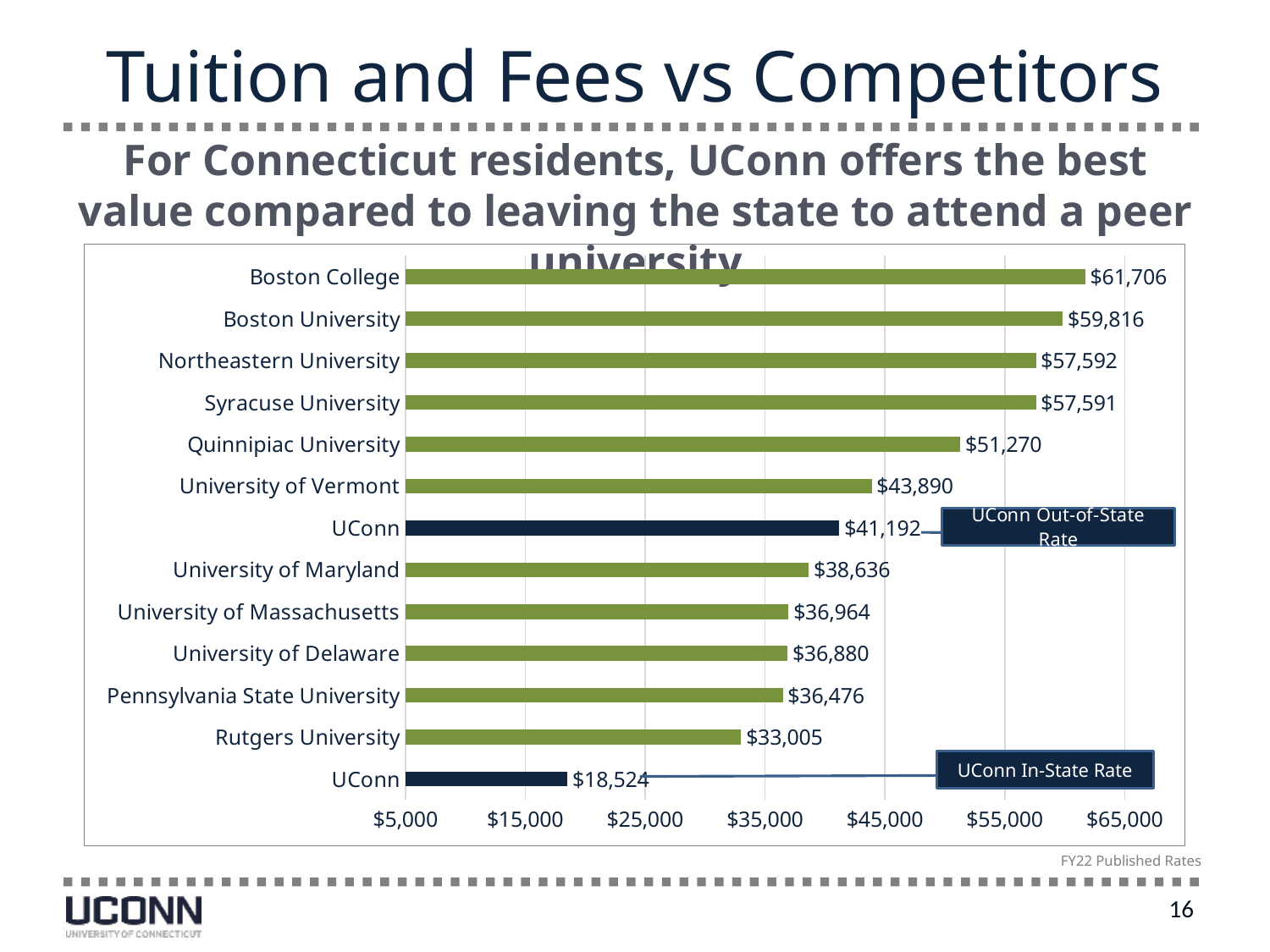
What is the tuition and fees value shown for Boston College? $61,706 What type of chart is shown on the slide? Bar chart Which is higher, the value for Quinnipiac University or the value for University of Vermont? Quinnipiac University What is the UConn In-State Rate shown on the chart? $18,524 Which bar shows the lowest tuition and fees on the chart? UConn (In-State Rate) What is the UConn Out-of-State Rate shown on the chart? $41,192 Which university has the highest tuition and fees on the chart? Boston College How many bars are plotted on the chart? 13 Is the value for Pennsylvania State University greater or less than $45,000? less What is the difference between Boston College's tuition and fees and the UConn In-State Rate? $43,182 What value is shown for Rutgers University? $33,005 What is the difference between the UConn Out-of-State Rate and the UConn In-State Rate? $22,668